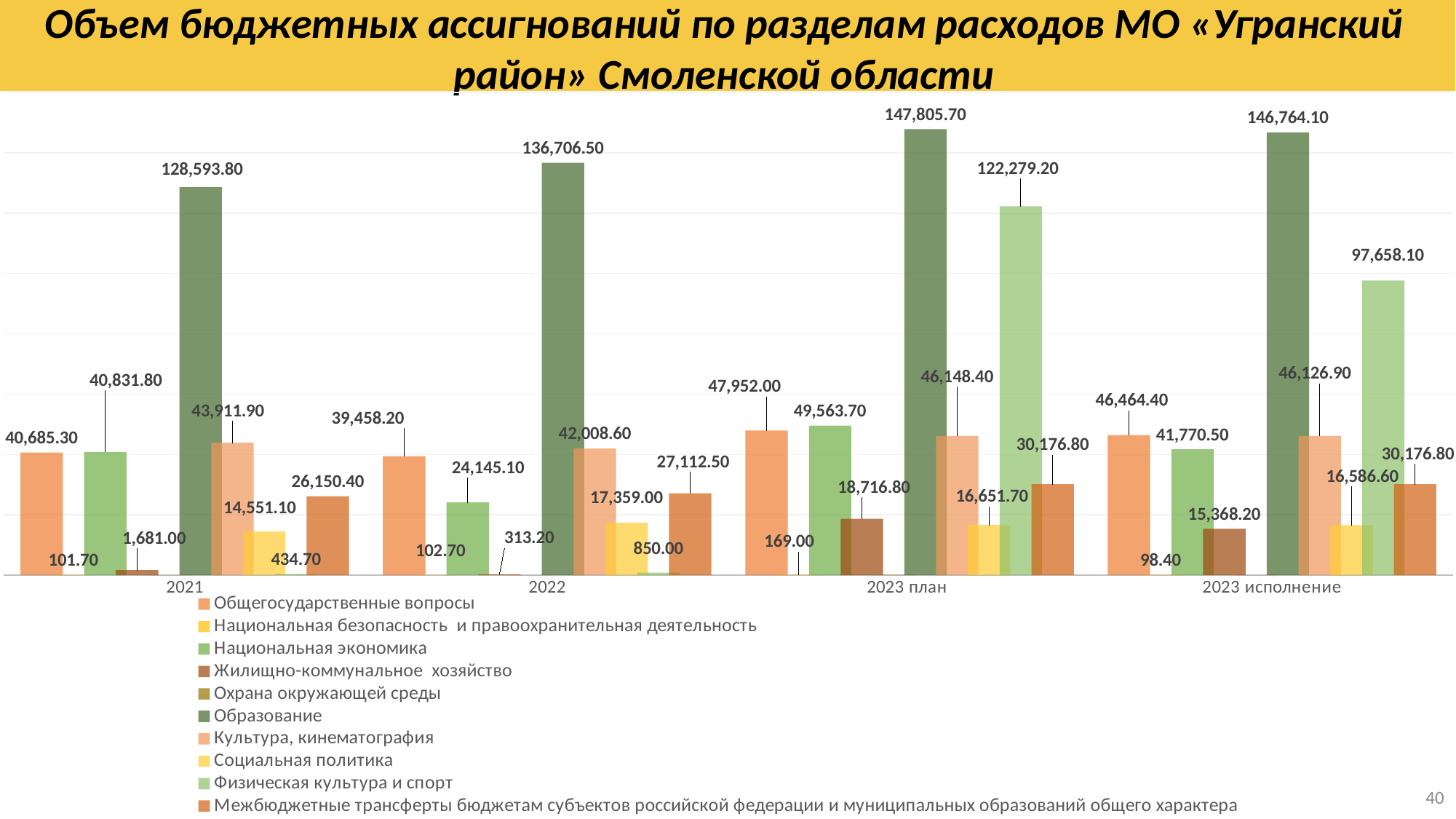
How many series does the legend list? 10 What type of chart is shown on the slide? Bar chart Which is larger: Национальная экономика in 2021 or in 2022? 2021 What is the value for Национальная безопасность и правоохранительная деятельность in 2023 исполнение? 98.40 What is the value for Физическая культура и спорт in 2023 план? 122,279.20 In which category does Образование reach its highest value? 2023 план Does the value for Образование rise or fall from 2021 to 2023 план? Rises What is the difference between Физическая культура и спорт in 2023 план and in 2023 исполнение? 24,621.10 How many categories are shown on the x axis? 4 What is the value for Образование in 2021? 128,593.80 Which series has the highest value in 2022? Образование What is the value for Межбюджетные трансферты in 2022? 27,112.50